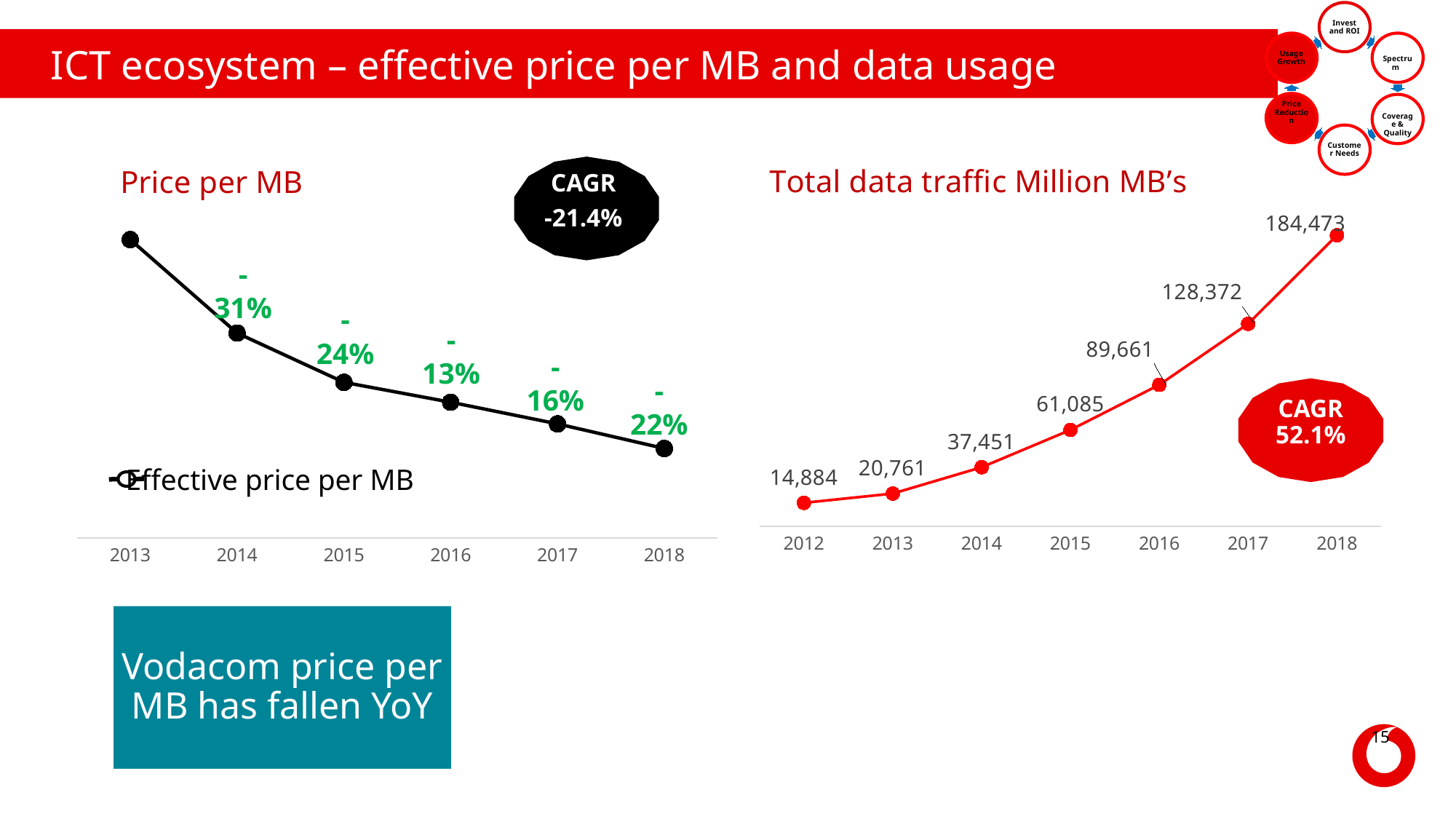
In the 'Total data traffic Million MB's' chart, which year has the lowest value? 2012 In the 'Price per MB' chart, what is the year-on-year change label shown for 2014? -31% In the 'Total data traffic Million MB's' chart, do the values rise or fall from 2012 to 2018? rise In the 'Total data traffic Million MB's' chart, how many years are plotted? 7 In the 'Total data traffic Million MB's' chart, which year has the highest value? 2018 In the 'Total data traffic Million MB's' chart, what is the value for 2015? 61,085 In the 'Total data traffic Million MB's' chart, what is the value for 2018? 184,473 In the 'Total data traffic Million MB's' chart, what is the difference between the 2018 and 2017 values? 56,101 In the 'Price per MB' chart, what is the year-on-year change label shown for 2016? -13% In the 'Price per MB' chart, does the effective price per MB rise or fall from 2013 to 2018? fall In the 'Total data traffic Million MB's' chart, what is the value for 2012? 14,884 What type of chart is the 'Price per MB' chart? line chart